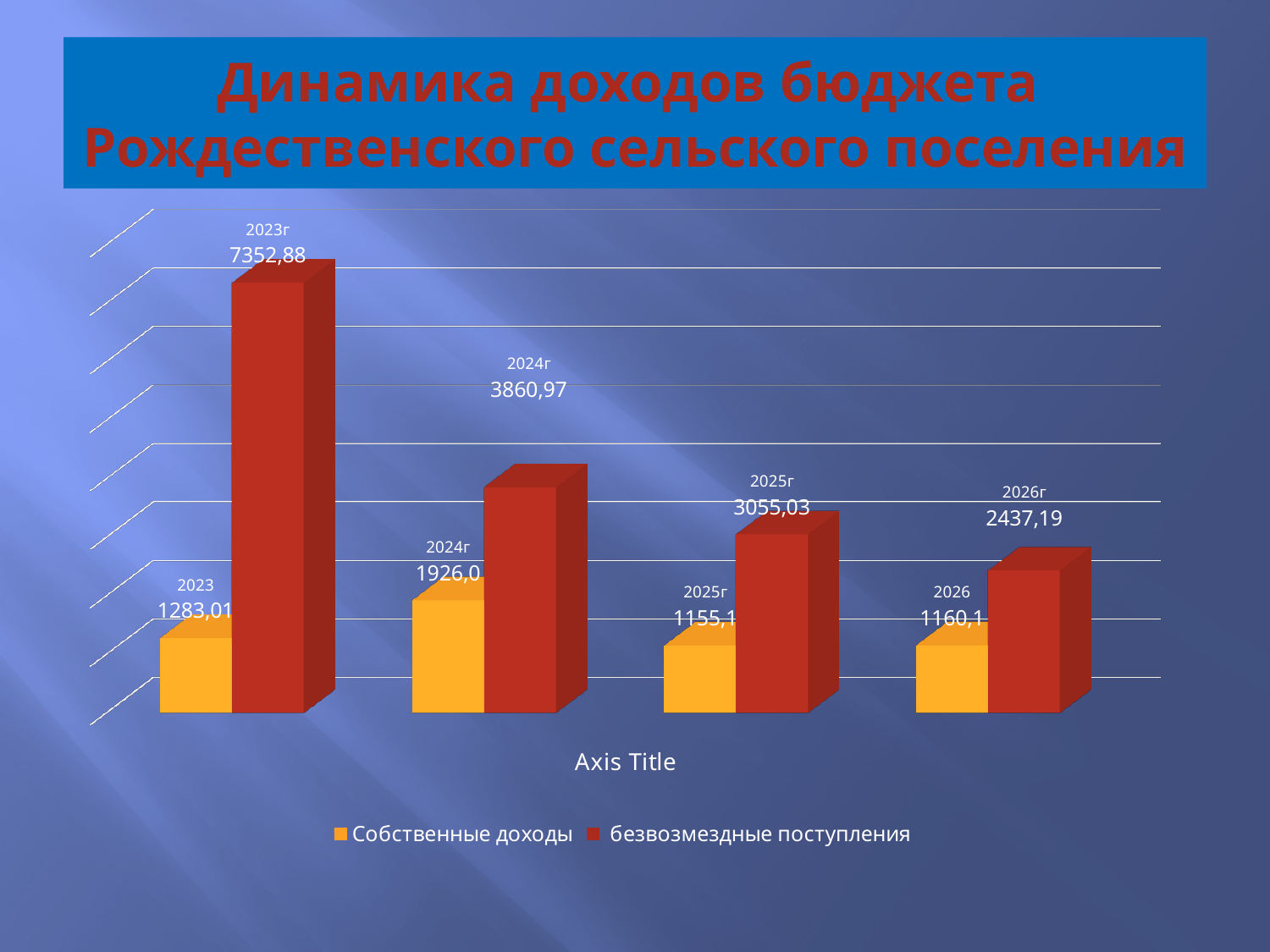
What is the difference between безвозмездные поступления in 2023 and 2024? 3491,91 What is the value of Собственные доходы for 2024? 1926,0 How many years are shown on the x axis? 4 What kind of chart is shown on the slide? Bar chart What is the value of безвозмездные поступления for 2026? 2437,19 In which year is безвозмездные поступления lowest? 2026 In which year is Собственные доходы highest? 2024 What is the value of безвозмездные поступления for 2023? 7352,88 What is the value of Собственные доходы for 2025? 1155,1 Which is larger: Собственные доходы in 2023 or in 2026? 2023 In which year is безвозмездные поступления highest? 2023 How many series does the legend list? 2